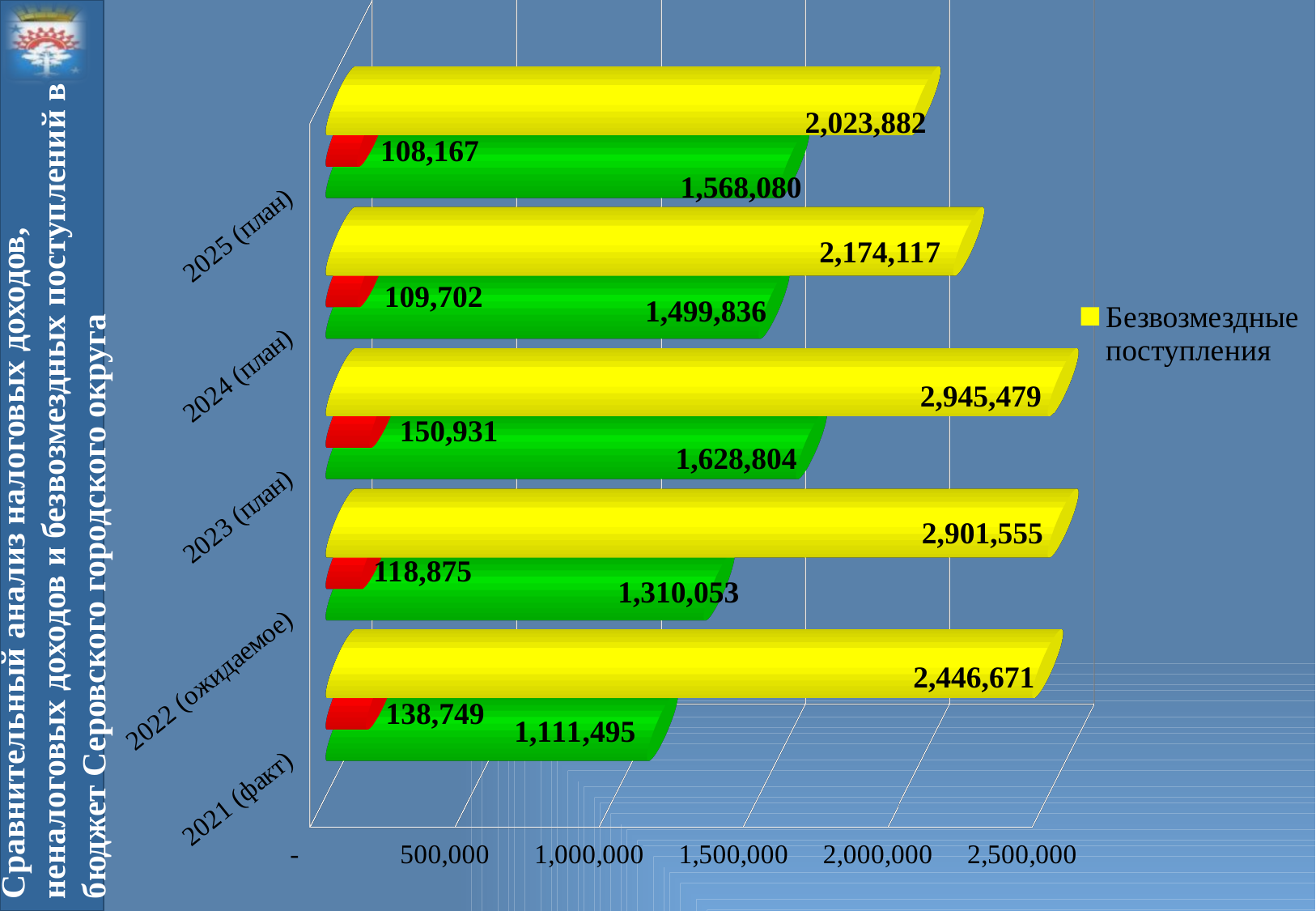
Which category has the lowest value for the red series? 2025 (план) What is the value of the yellow bar (Безвозмездные поступления) for 2023 (план)? 2,945,479 Which category has the highest value for the yellow series (Безвозмездные поступления)? 2023 (план) Which category has the lowest value for the green series? 2021 (факт) Which is larger: the green bar for 2024 (план) or the green bar for 2025 (план)? 2025 (план) What is the value of the red bar for 2024 (план)? 109,702 How many categories are shown on the chart? 5 What is the value of the green bar for 2021 (факт)? 1,111,495 What is the value of the yellow bar (Безвозмездные поступления) for 2025 (план)? 2,023,882 What type of chart is shown on the slide? Bar chart What is the difference between the yellow bar values for 2022 (ожидаемое) and 2021 (факт)? 454,884 Which series name is shown in the legend? Безвозмездные поступления